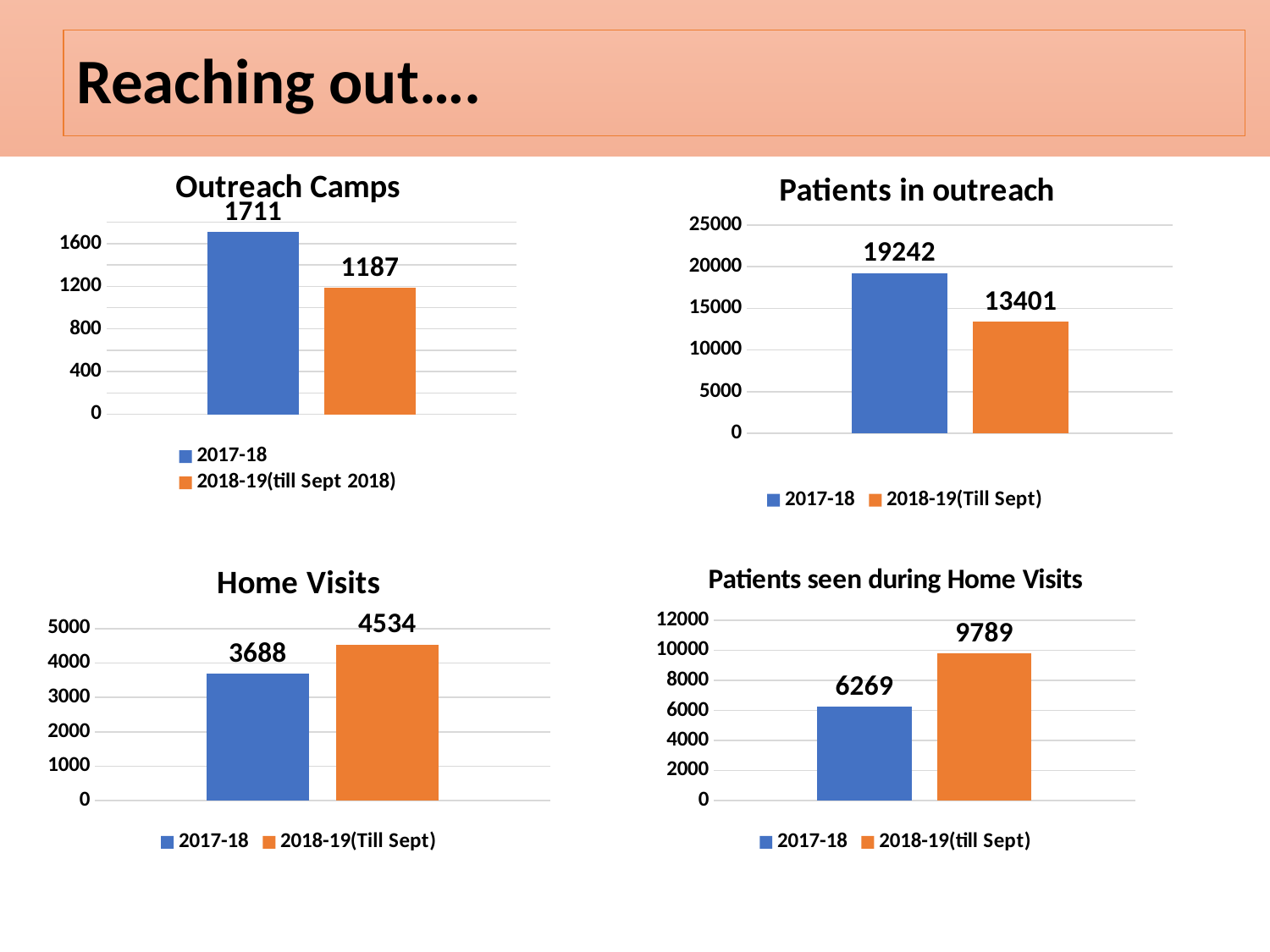
In the Home Visits chart, which series has the higher value, 2017-18 or 2018-19(Till Sept)? 2018-19(Till Sept) In the Home Visits chart, what is the value for 2017-18? 3688 In the Patients in outreach chart, what is the value for 2018-19(Till Sept)? 13401 In the Patients seen during Home Visits chart, what is the difference between the 2018-19(till Sept) and 2017-18 values? 3520 In the Outreach Camps chart, what is the value for 2018-19(till Sept 2018)? 1187 In the Patients seen during Home Visits chart, what is the value for 2018-19(till Sept)? 9789 In the Patients in outreach chart, what is the difference between the 2017-18 and 2018-19(Till Sept) values? 5841 What kind of chart is the Patients in outreach chart? bar chart In the Outreach Camps chart, what is the value for 2017-18? 1711 How many series does the legend of the Home Visits chart list? 2 In the Patients seen during Home Visits chart, is the value for 2017-18 greater or less than 8000? less In the Outreach Camps chart, which series has the lowest value? 2018-19(till Sept 2018)